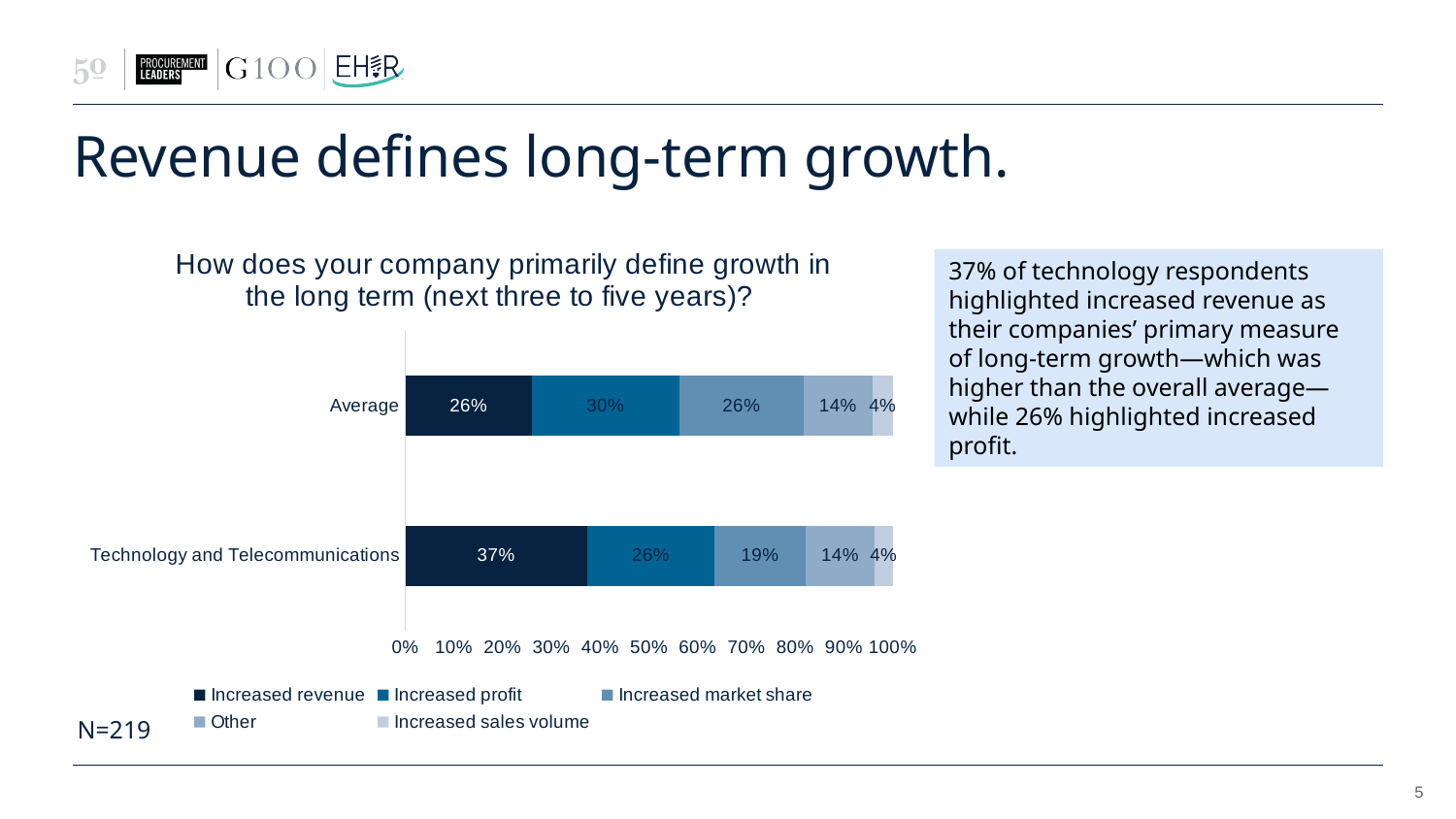
What is the Increased profit value for the Average bar? 30% What is the total of the segments in the Average bar? 100% How many percentage points higher is Increased revenue for Technology and Telecommunications than for Average? 11 percentage points What is the Increased revenue value for the Average bar? 26% What percentage of Technology and Telecommunications respondents chose Increased revenue? 37% What is the difference in Increased profit between Average and Technology and Telecommunications? 4 percentage points Which series is the largest segment in the Technology and Telecommunications bar? Increased revenue Which bar has the larger Increased market share value, Average or Technology and Telecommunications? Average What type of chart is shown on the slide? Stacked bar chart What is the Increased market share value for Technology and Telecommunications? 19% How many series does the legend list? 5 How many categories (bars) are shown in the chart? 2